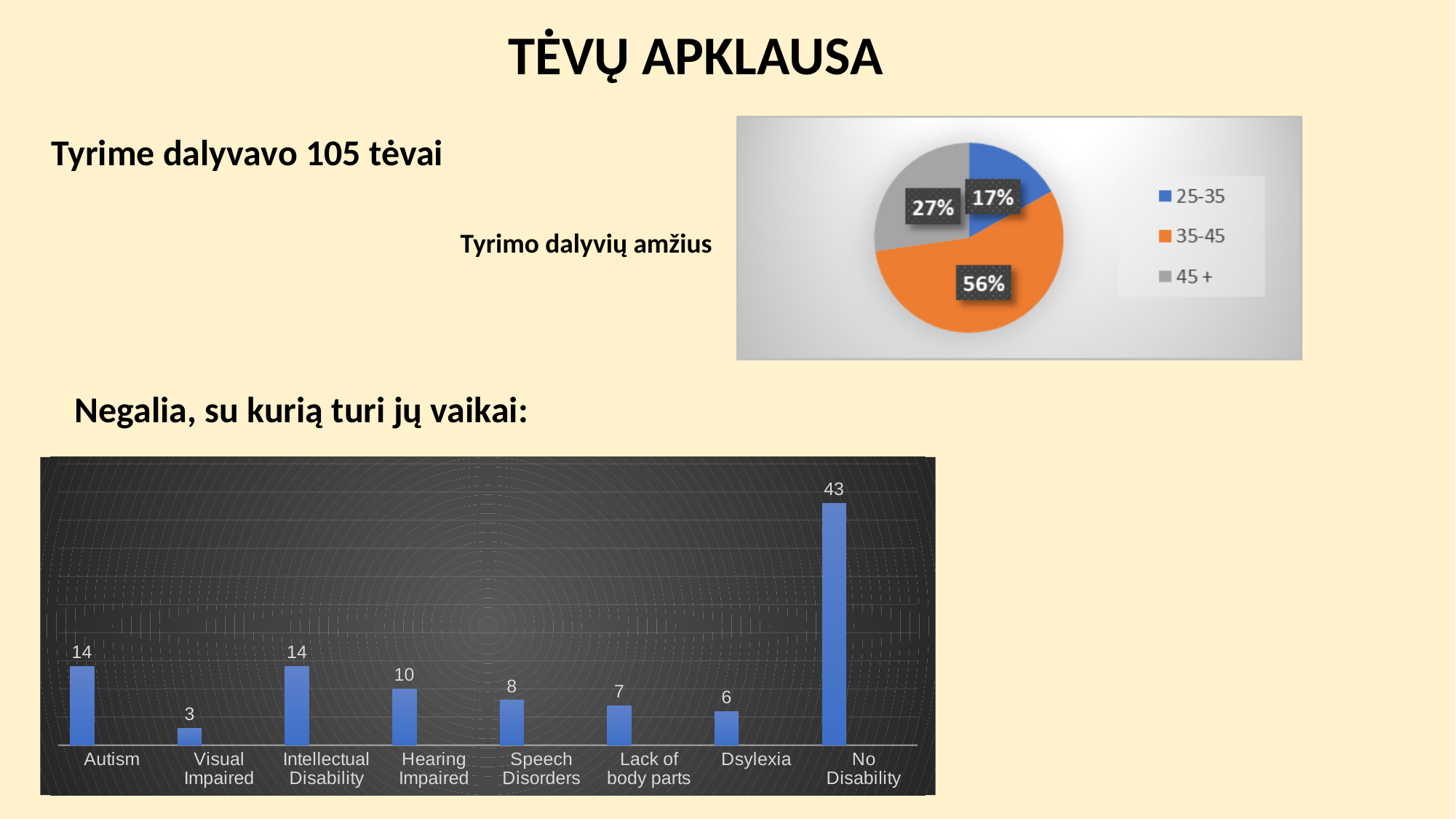
In the bar chart at the bottom of the slide, which is larger: the value for Speech Disorders or the value for Dsylexia? Speech Disorders In the bar chart at the bottom of the slide, which category has the highest value? No Disability In the bar chart at the bottom of the slide, what is the value for No Disability? 43 In the bar chart at the bottom of the slide, what is the value for Hearing Impaired? 10 In the bar chart at the bottom of the slide, how many categories are shown? 8 In the pie chart (Tyrimo dalyvių amžius), which age group has the smallest share? 25-35 In the pie chart (Tyrimo dalyvių amžius), what share of participants are aged 35-45? 56% In the bar chart at the bottom of the slide, which category has the lowest value? Visual Impaired In the bar chart at the bottom of the slide, what is the difference between the values for No Disability and Autism? 29 In the pie chart (Tyrimo dalyvių amžius), how many age groups does the legend list? 3 In the pie chart (Tyrimo dalyvių amžius), which colour represents the 35-45 group? Orange In the pie chart (Tyrimo dalyvių amžius), what share of participants are aged 45 +? 27%